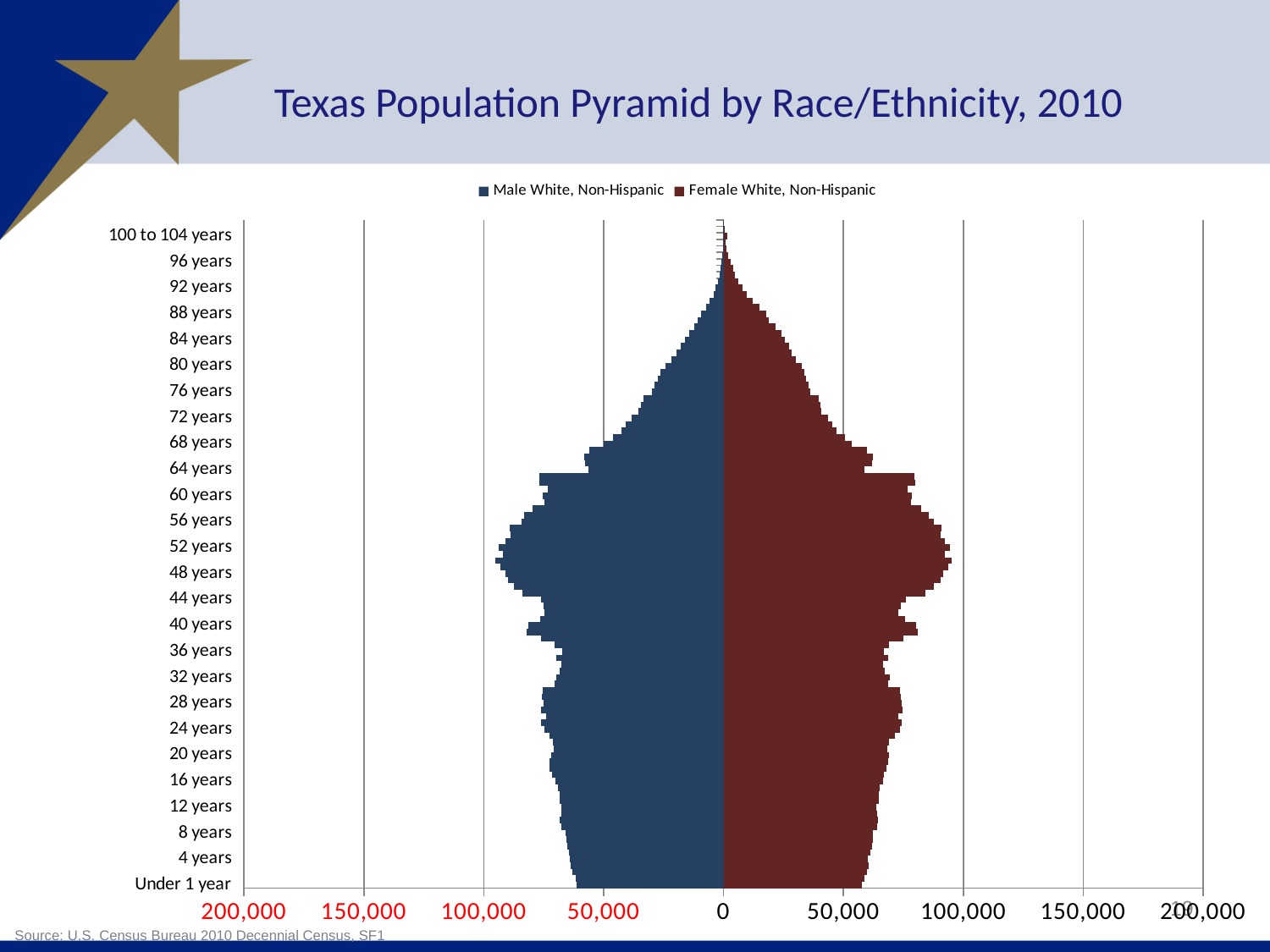
What is the title of the chart? Texas Population Pyramid by Race/Ethnicity, 2010 Is the value for Male White, Non-Hispanic at Under 1 year greater or less than 100,000? less At 88 years, which is larger: the Male White, Non-Hispanic value or the Female White, Non-Hispanic value? Female White, Non-Hispanic What kind of chart is shown on the slide? Bar chart (population pyramid) Is the value for Female White, Non-Hispanic at 76 years greater or less than 50,000? less Is the value for Male White, Non-Hispanic at 48 years greater or less than 50,000? greater How many series does the legend list? 2 Which series is shown in dark red? Female White, Non-Hispanic